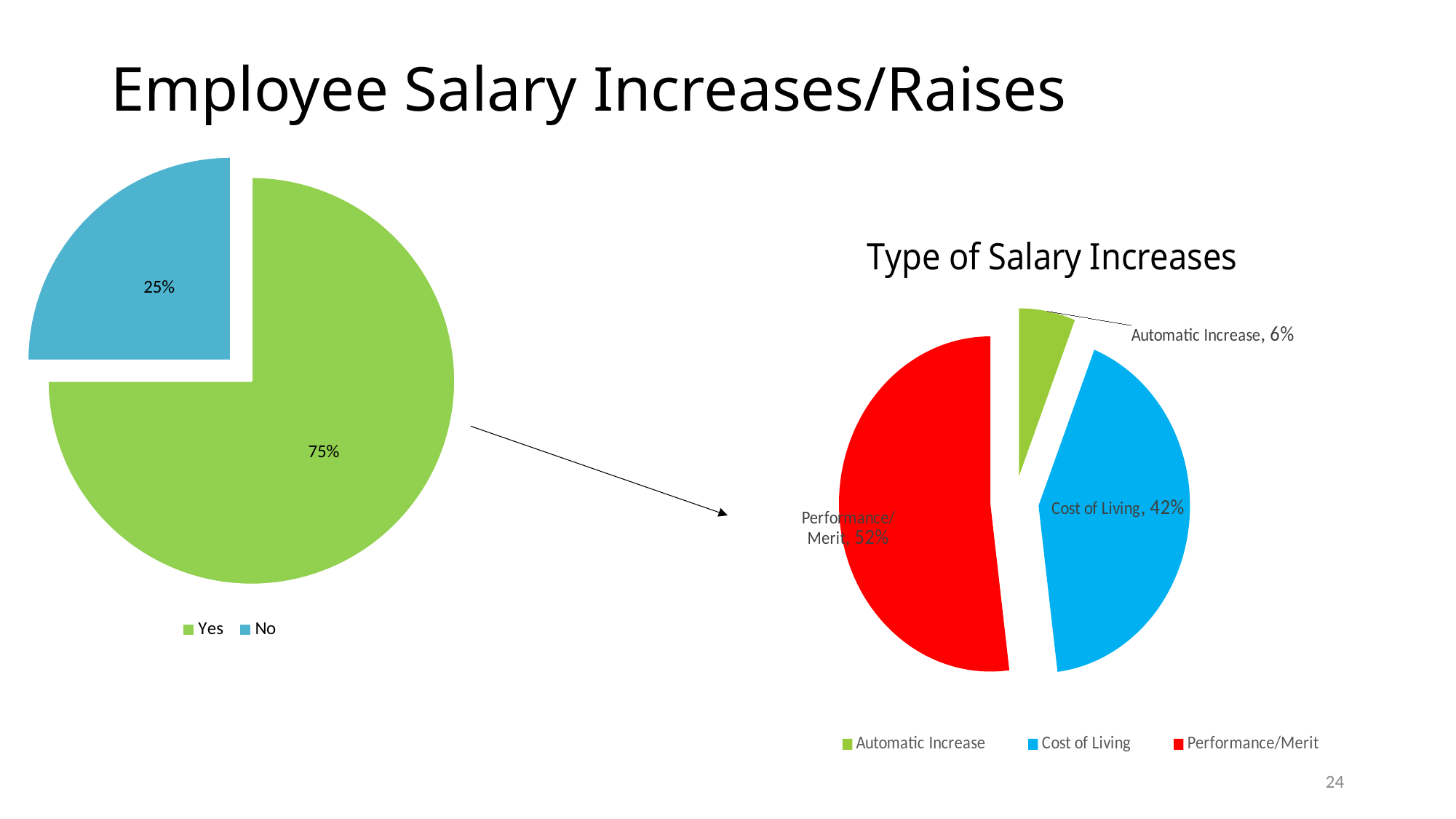
In the left pie chart, which category has the larger share, Yes or No? Yes In the Type of Salary Increases chart, what is the difference between the Performance/Merit and Cost of Living shares? 10% In the left pie chart, what is the difference between the Yes and No shares? 50% In the Type of Salary Increases chart, which category has the largest share? Performance/Merit In the left pie chart, what percentage is shown for Yes? 75% In the Type of Salary Increases chart, what percentage is Automatic Increase? 6% What kind of chart is the Type of Salary Increases chart? Pie chart In the Type of Salary Increases chart, which category has the smallest share? Automatic Increase In the left pie chart, what percentage is shown for No? 25% In the Type of Salary Increases chart, what percentage is Performance/Merit? 52% How many entries does the legend of the left pie chart list? 2 In the Type of Salary Increases chart, what percentage is Cost of Living? 42%